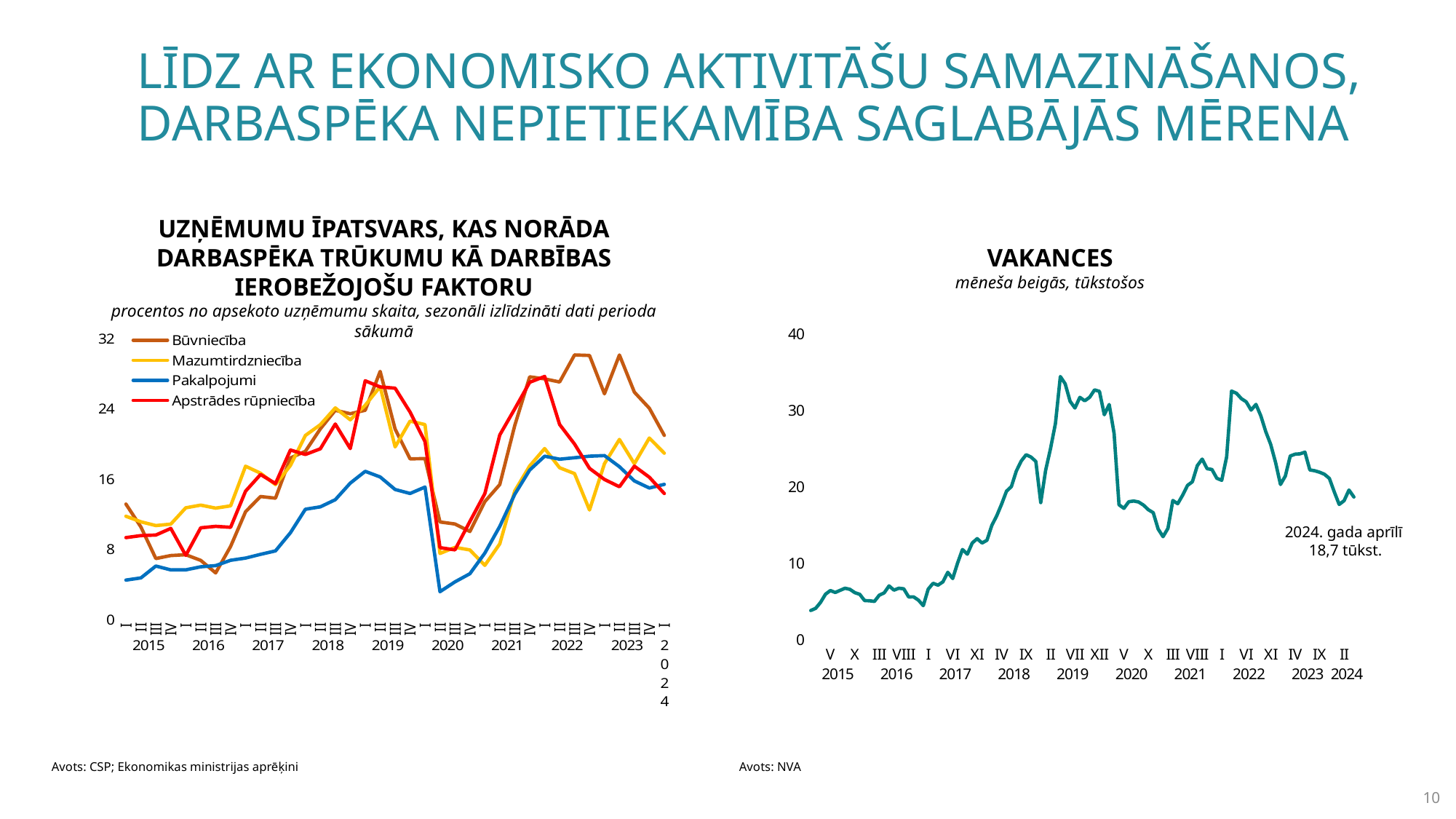
How many series does the legend of the left chart list? 4 In the right chart 'Vakances', is the value at the start of the series in 2015 greater or less than 10? less In the left chart, at the 2020 dip, which series is lower: Pakalpojumi or Būvniecība? Pakalpojumi In the right chart 'Vakances', do values generally rise or fall from 2015 to 2019? Rise In the left chart, which series reaches the highest value during 2022–2023? Būvniecība What is the source given for the right chart 'Vakances'? NVA What kind of chart is the left chart, 'Uzņēmumu īpatsvars, kas norāda darbaspēka trūkumu kā darbības ierobežojošu faktoru'? Line chart In the left chart, which colour represents Pakalpojumi? Blue In the right chart 'Vakances', is the peak value reached in 2019 greater or less than 30? greater In the left chart, is the highest value of Būvniecība in 2022 greater or less than 24? greater In the right chart 'Vakances', what value is annotated for April 2024? 18,7 tūkst.